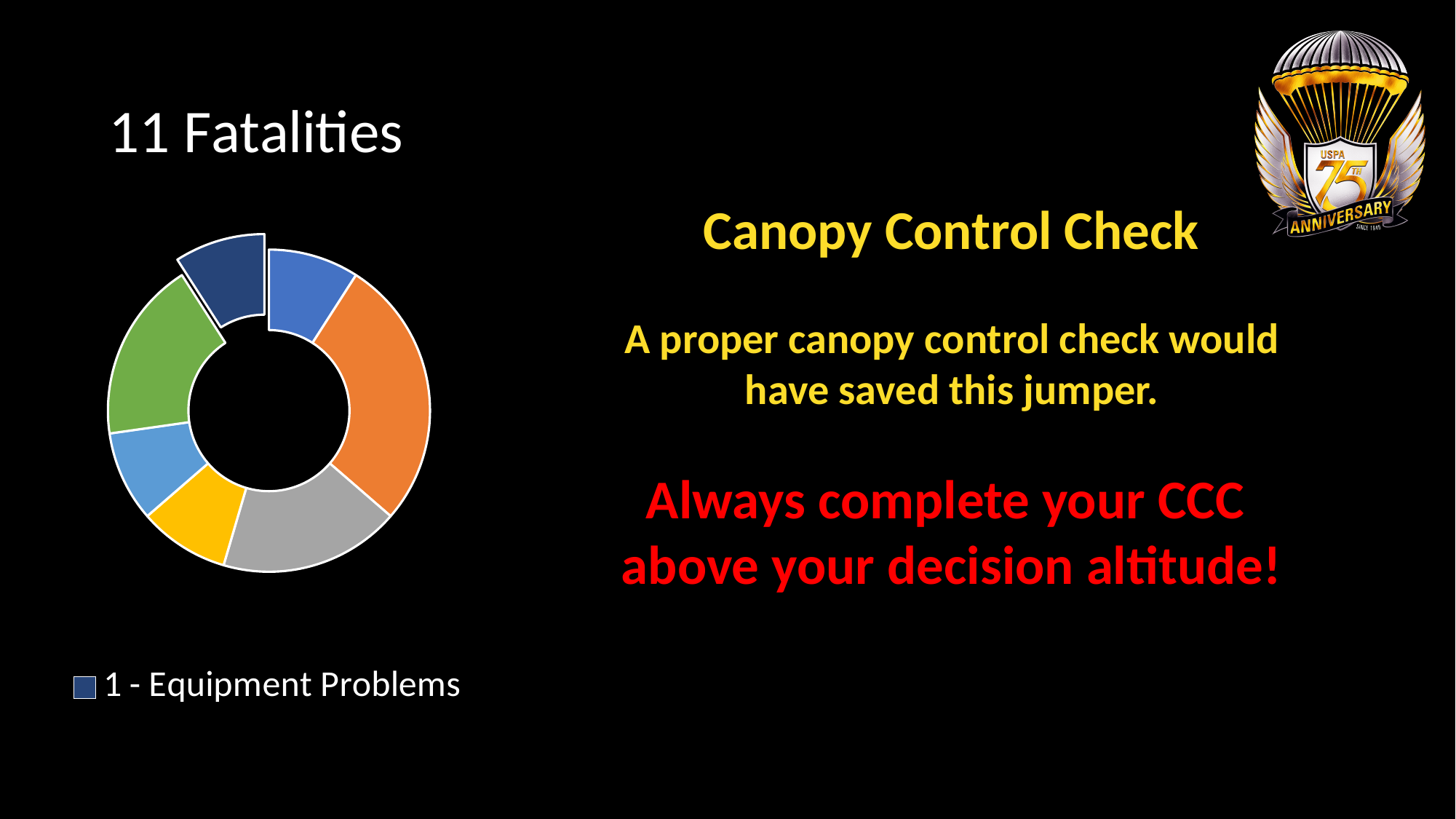
According to the legend, how many fatalities are attributed to Equipment Problems? 1 How many entries does the chart legend list? 1 Is the Equipment Problems slice the largest slice in the doughnut chart? No What kind of chart is shown on the slide? Doughnut chart Which category does the slice pulled out from the ring represent? 1 - Equipment Problems How many slices does the doughnut chart have? 7 What is the title shown above the doughnut chart? 11 Fatalities